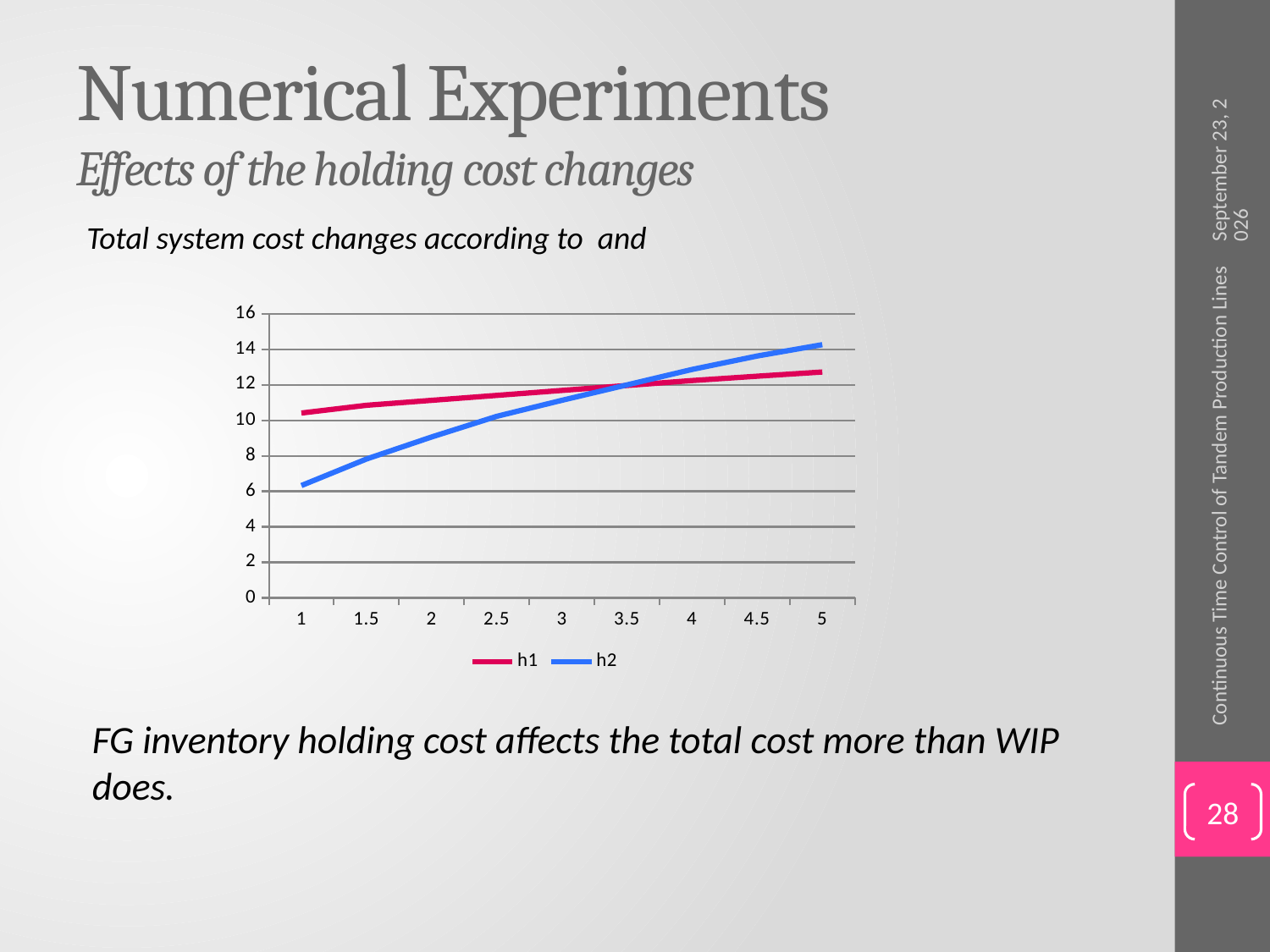
Is the value of h2 at x = 5 greater or less than 12? greater Does the h1 line rise or fall as the x-axis value increases from 1 to 5? rises At x = 1, which series has the higher value, h1 or h2? h1 Does the h2 line rise or fall as the x-axis value increases from 1 to 5? rises Is the value of h2 at x = 1 greater or less than 8? less What are the names of the two series in the chart legend? h1 and h2 What kind of chart is shown on the slide? line chart How many series does the chart legend list? 2 At x = 5, which series has the higher value, h1 or h2? h2 How many x-axis tick labels are shown on the chart? 9 Is the value of h1 at x = 5 greater or less than 14? less What colour is the h2 line in the chart? blue